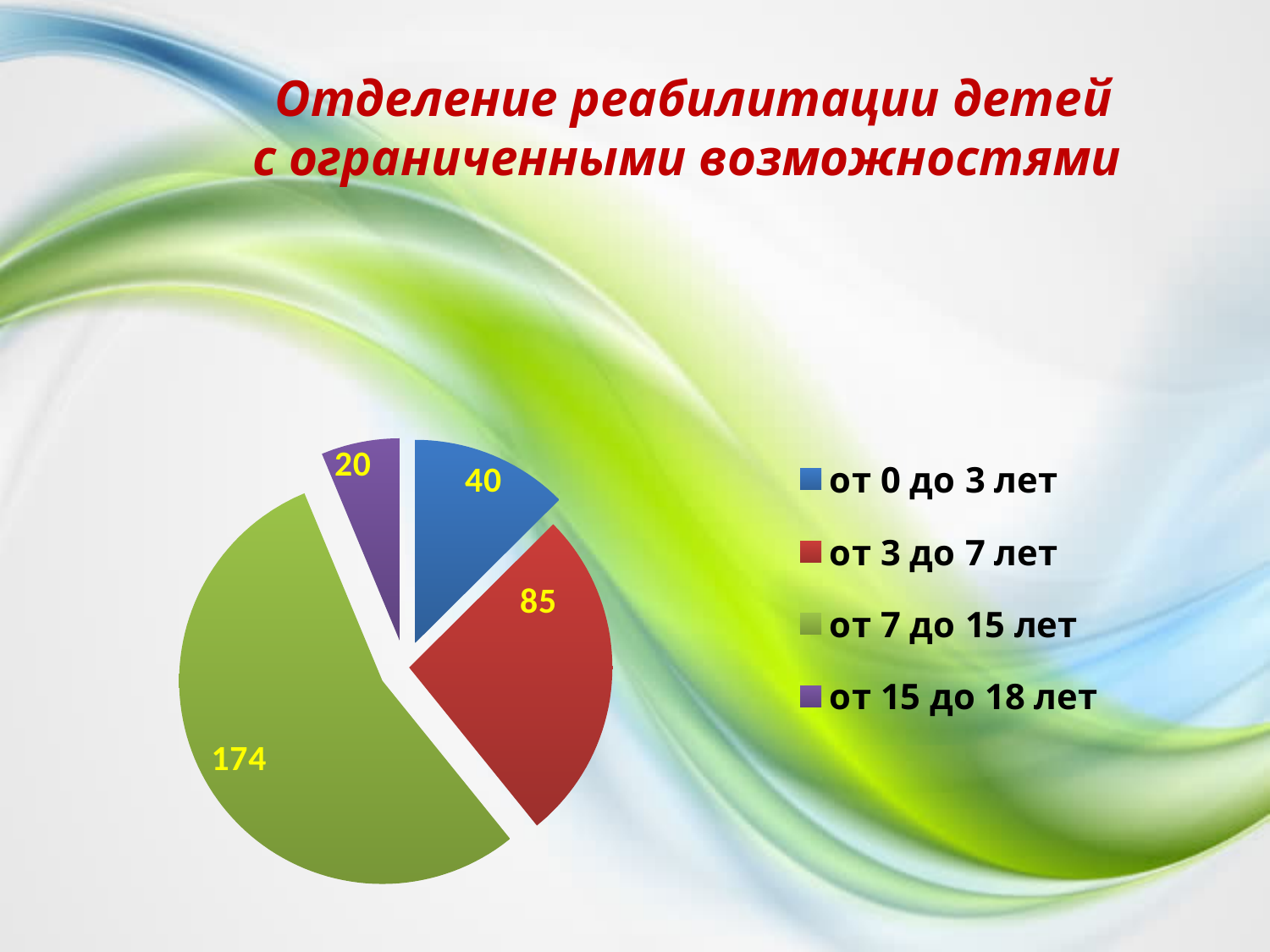
What is the value for the slice "от 3 до 7 лет"? 85 What is the value for the slice "от 7 до 15 лет"? 174 Which age group has the largest slice of the pie? от 7 до 15 лет What is the difference between the values for "от 0 до 3 лет" and "от 15 до 18 лет"? 20 What is the value for the slice "от 0 до 3 лет"? 40 What is the value for the slice "от 15 до 18 лет"? 20 What kind of chart is shown on the slide? Pie chart What colour is the slice for "от 15 до 18 лет"? Purple How many slices does the pie chart have? 4 Which age group has the smallest slice of the pie? от 15 до 18 лет Which is larger: the value for "от 3 до 7 лет" or the value for "от 0 до 3 лет"? от 3 до 7 лет What is the difference between the values for "от 7 до 15 лет" and "от 3 до 7 лет"? 89